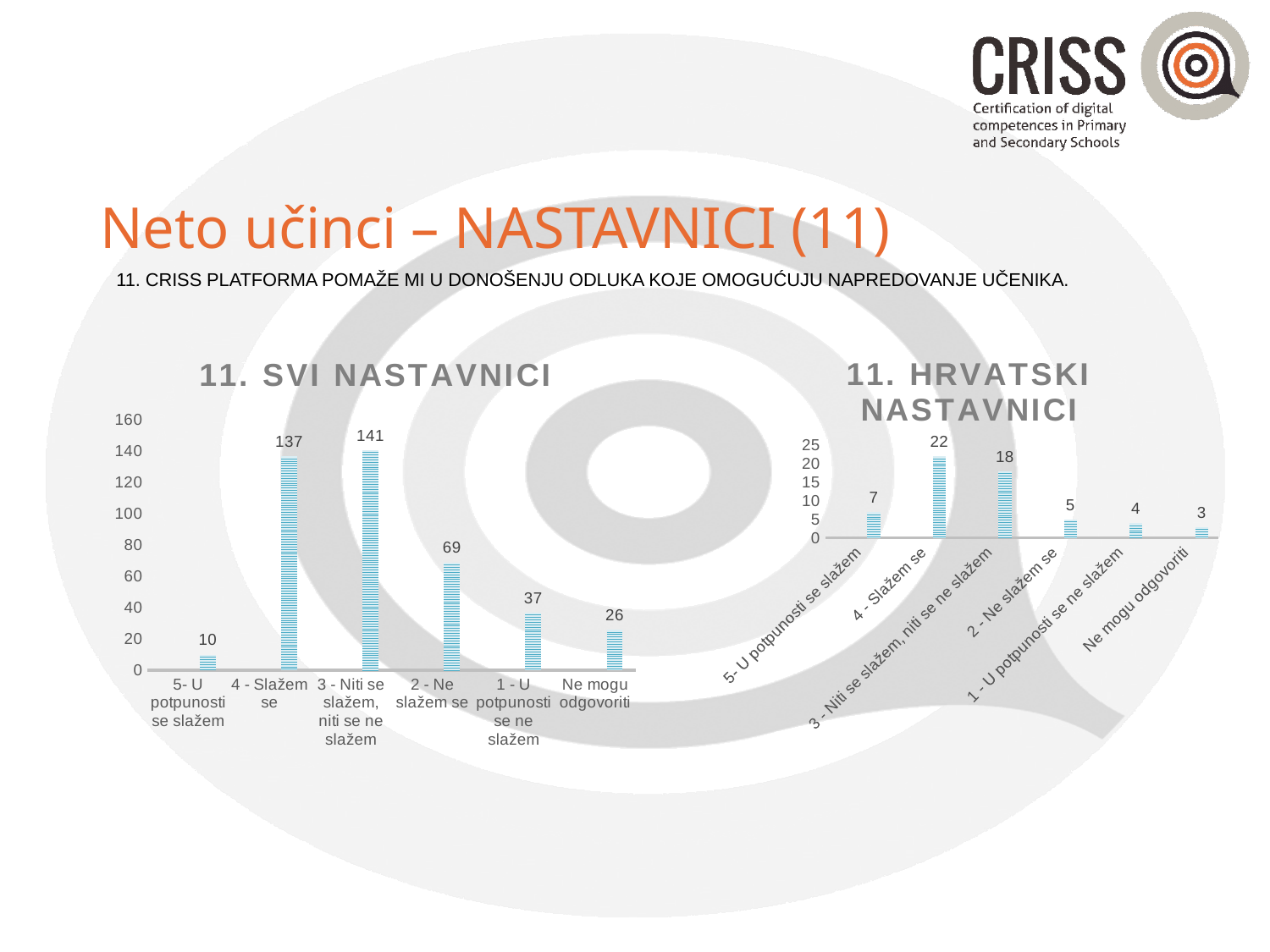
In the chart titled "11. SVI NASTAVNICI", which category has the lowest value? 5- U potpunosti se slažem In the chart titled "11. SVI NASTAVNICI", what is the value for "4 - Slažem se"? 137 In the chart titled "11. HRVATSKI NASTAVNICI", which is larger: the value for "4 - Slažem se" or the value for "3 - Niti se slažem, niti se ne slažem"? 4 - Slažem se In the chart titled "11. SVI NASTAVNICI", what is the difference between the values for "2 - Ne slažem se" and "1 - U potpunosti se ne slažem"? 32 In the chart titled "11. HRVATSKI NASTAVNICI", what is the value for "5- U potpunosti se slažem"? 7 In the chart titled "11. HRVATSKI NASTAVNICI", which category has the lowest value? Ne mogu odgovoriti In the chart titled "11. SVI NASTAVNICI", which category has the highest value? 3 - Niti se slažem, niti se ne slažem In the chart titled "11. SVI NASTAVNICI", how many categories are shown on the x axis? 6 In the chart titled "11. HRVATSKI NASTAVNICI", what is the value for "4 - Slažem se"? 22 In the chart titled "11. SVI NASTAVNICI", what is the value for "Ne mogu odgovoriti"? 26 In the chart titled "11. HRVATSKI NASTAVNICI", what is the difference between the values for "4 - Slažem se" and "2 - Ne slažem se"? 17 What type of chart is the chart titled "11. SVI NASTAVNICI"? Bar chart